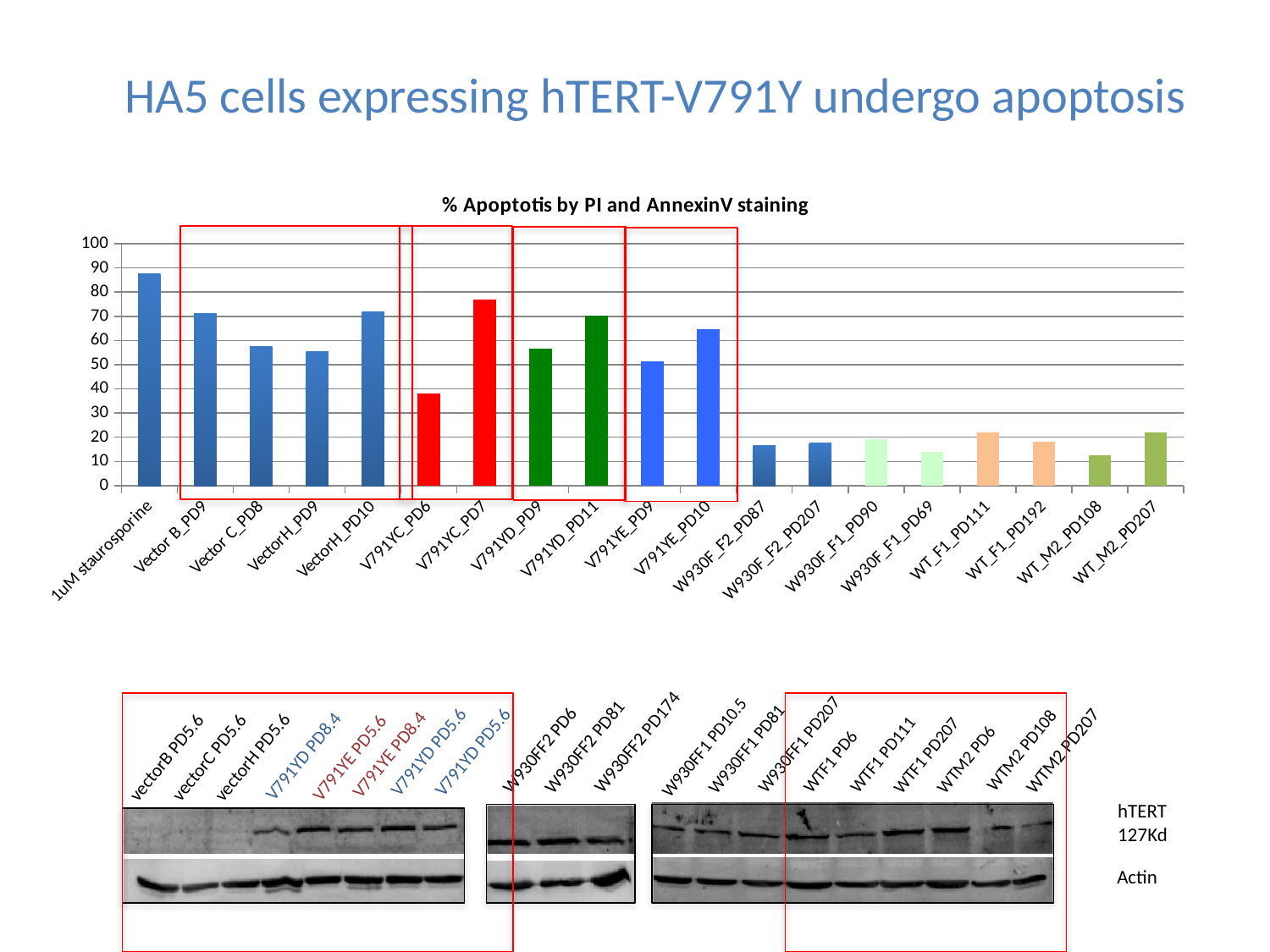
Is the value for V791YC_PD7 greater or less than 70? greater What type of chart is shown on the slide? bar chart Is the value for W930F_F2_PD87 greater or less than 30? less Is the value for V791YD_PD11 greater or less than 60? greater Which is larger, the value for V791YE_PD10 or WT_F1_PD111? V791YE_PD10 Which is larger, the value for VectorH_PD9 or VectorH_PD10? VectorH_PD10 Which category has the highest value in the chart? 1uM staurosporine Which is larger, the value for V791YC_PD6 or V791YC_PD7? V791YC_PD7 What is the title of the chart? % Apoptotis by PI and AnnexinV staining How many categories are plotted on the x axis of the chart? 19